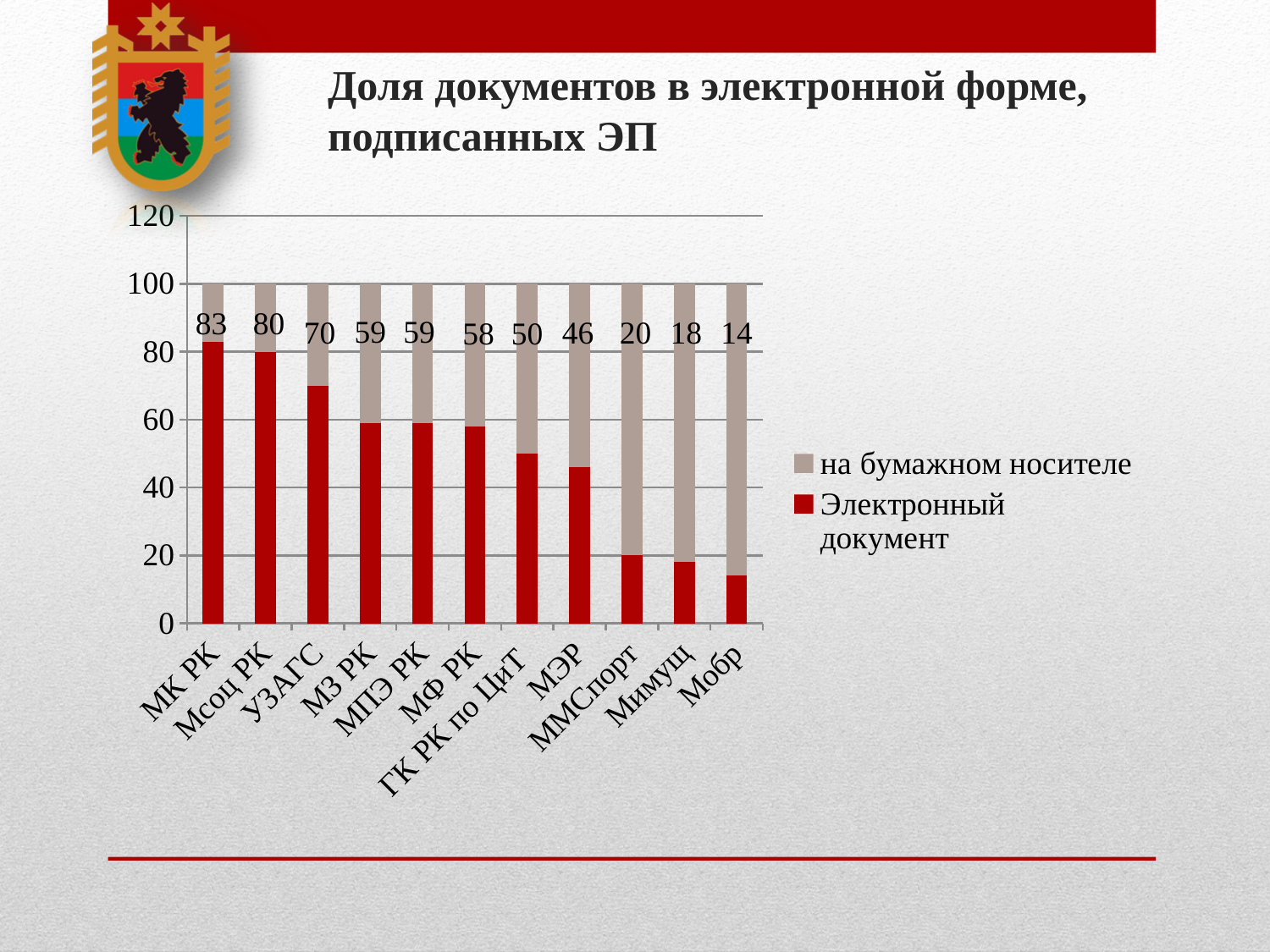
What is the value of the Электронный документ series for Мимущ? 18 What is the value of the Электронный документ series for ГК РК по ЦиТ? 50 Which has a larger Электронный документ value, УЗАГС or МЭР? УЗАГС Is the Электронный документ value for ММСпорт greater or less than 40? less What kind of chart is shown on the slide? bar chart Which category has the highest value for Электронный документ? МК РК What is the difference between the Электронный документ values for МК РК and Мобр? 69 Do the Электронный документ values rise or fall from left to right along the x axis? fall What is the value of the Электронный документ series for МК РК? 83 How many categories are shown on the x axis? 11 Which category has the lowest value for Электронный документ? Мобр How many series does the legend list? 2